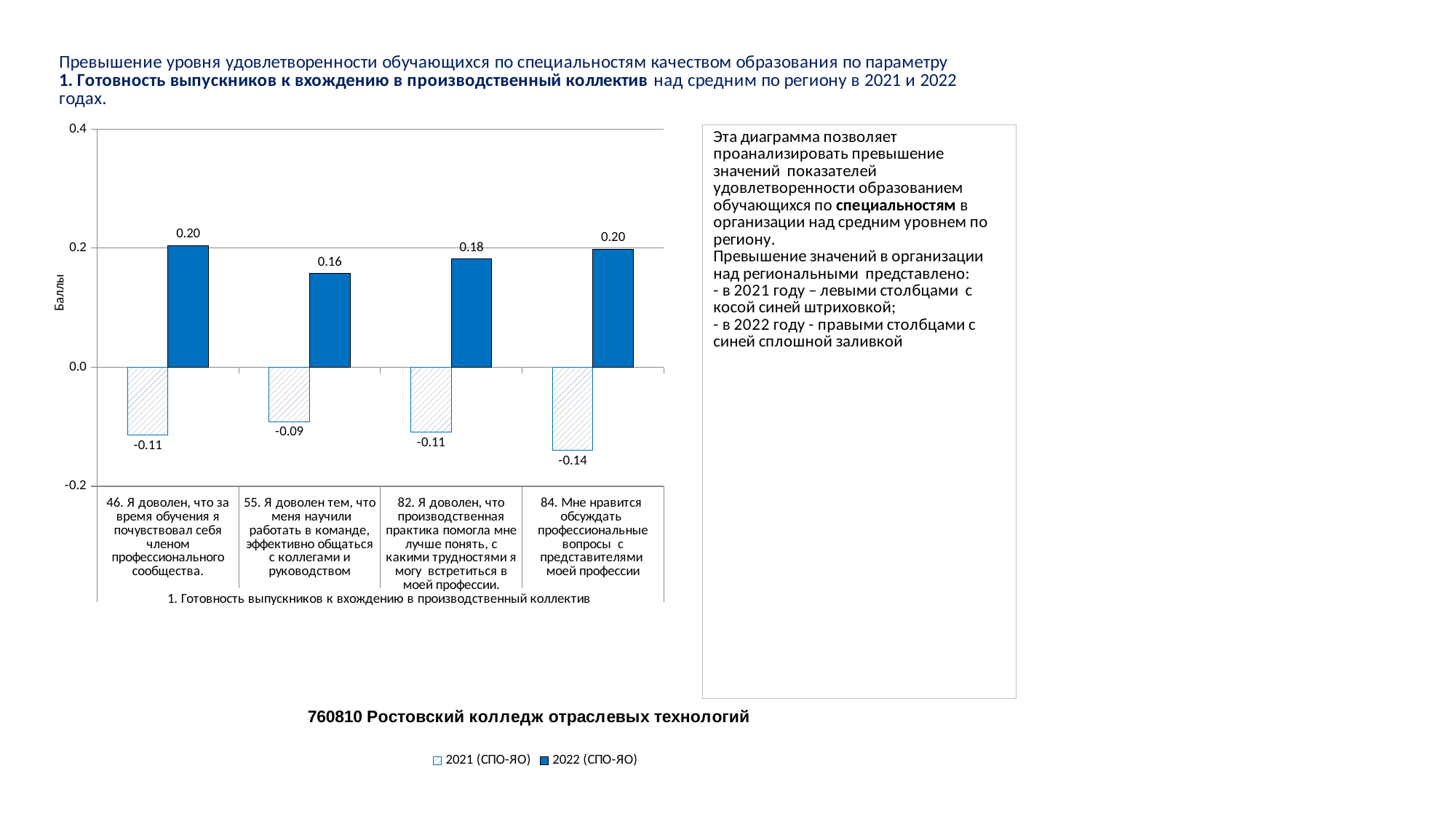
What is the 2021 (СПО-ЯО) value for category 84 ("Мне нравится обсуждать профессиональные вопросы...")? -0.14 How many categories are shown on the x axis of the chart? 4 What is the difference between the 2022 and 2021 values for category 46? 0.31 What is the 2022 (СПО-ЯО) value for category 82 ("Я доволен, что производственная практика помогла мне...")? 0.18 What is the label of the vertical axis of the chart? Баллы Which series is shown with hatched (striped) bars according to the legend? 2021 (СПО-ЯО) What kind of chart is shown on the slide? Bar chart Which category has the lowest 2022 (СПО-ЯО) value? 55. Я доволен тем, что меня научили работать в команде, эффективно общаться с коллегами и руководством Which is larger for category 82: the 2022 (СПО-ЯО) value or the 2022 value for category 55? Category 82 (0.18) What is the 2022 (СПО-ЯО) value for category 55 ("Я доволен тем, что меня научили работать в команде...")? 0.16 How many series does the legend list? 2 Which category has the lowest 2021 (СПО-ЯО) value? 84. Мне нравится обсуждать профессиональные вопросы с представителями моей профессии